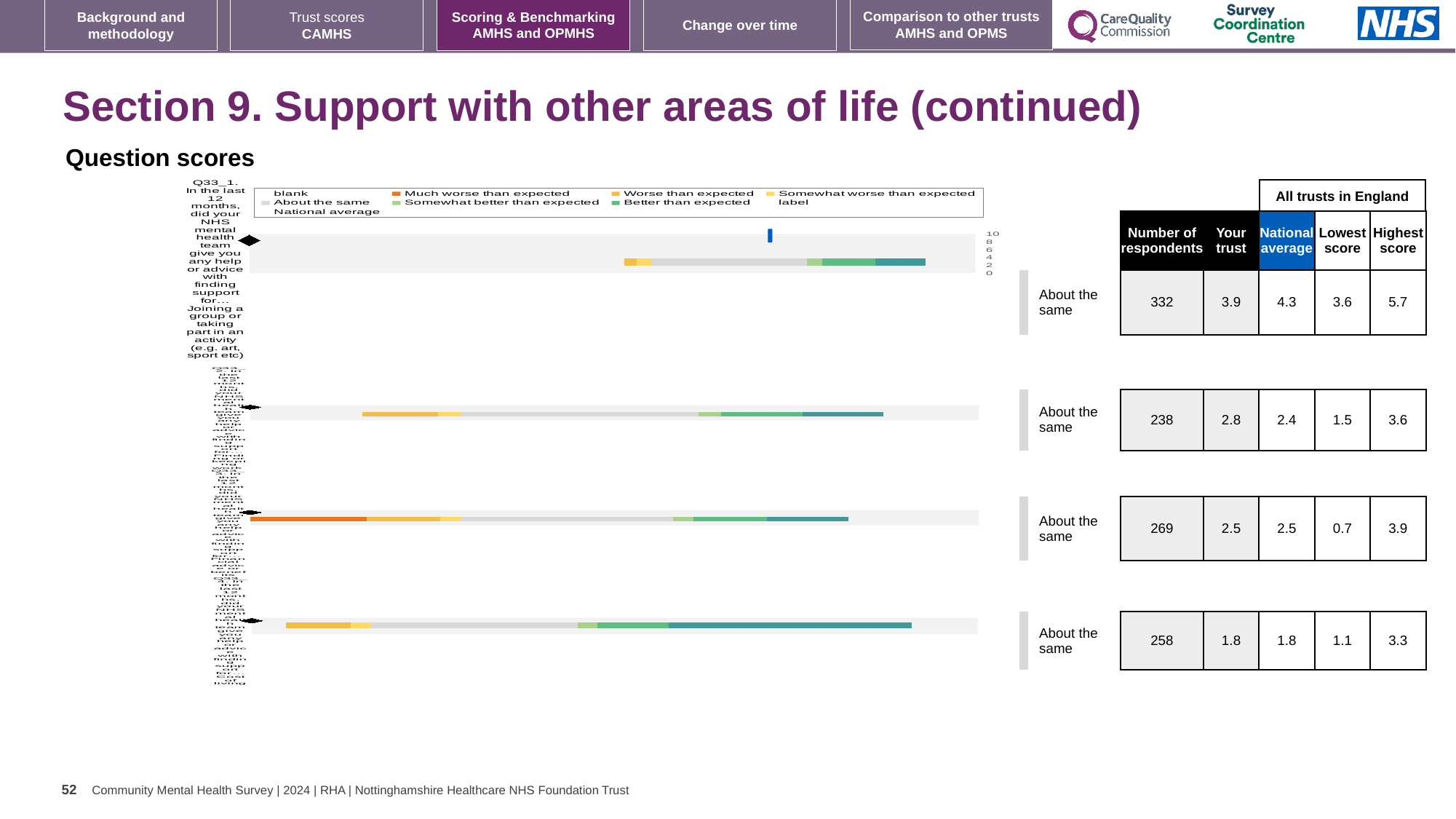
What is the last entry listed in the chart legend? National average How many entries does the chart legend list? 9 For Q33_1 (joining a group or taking part in an activity), what benchmark category is the trust's result labelled as? About the same How many bars (question rows) does the chart contain? 4 For Q33_1 (help or advice with joining a group or taking part in an activity), what is the number of respondents? 332 For Q33_1 (joining a group or taking part in an activity), what is the 'Your trust' score? 3.9 What kind of chart is shown on the slide? bar chart Which legend entry is shown in orange, immediately after 'blank'? Much worse than expected For Q33_1 (joining a group or taking part in an activity), which is larger: the 'Your trust' score or the national average? National average For Q33_1 (joining a group or taking part in an activity), what is the difference between the highest score and the lowest score? 2.1 For Q33_1 (joining a group or taking part in an activity), what is the national average score? 4.3 For Q33_1 (joining a group or taking part in an activity), what is the highest score among all trusts in England? 5.7